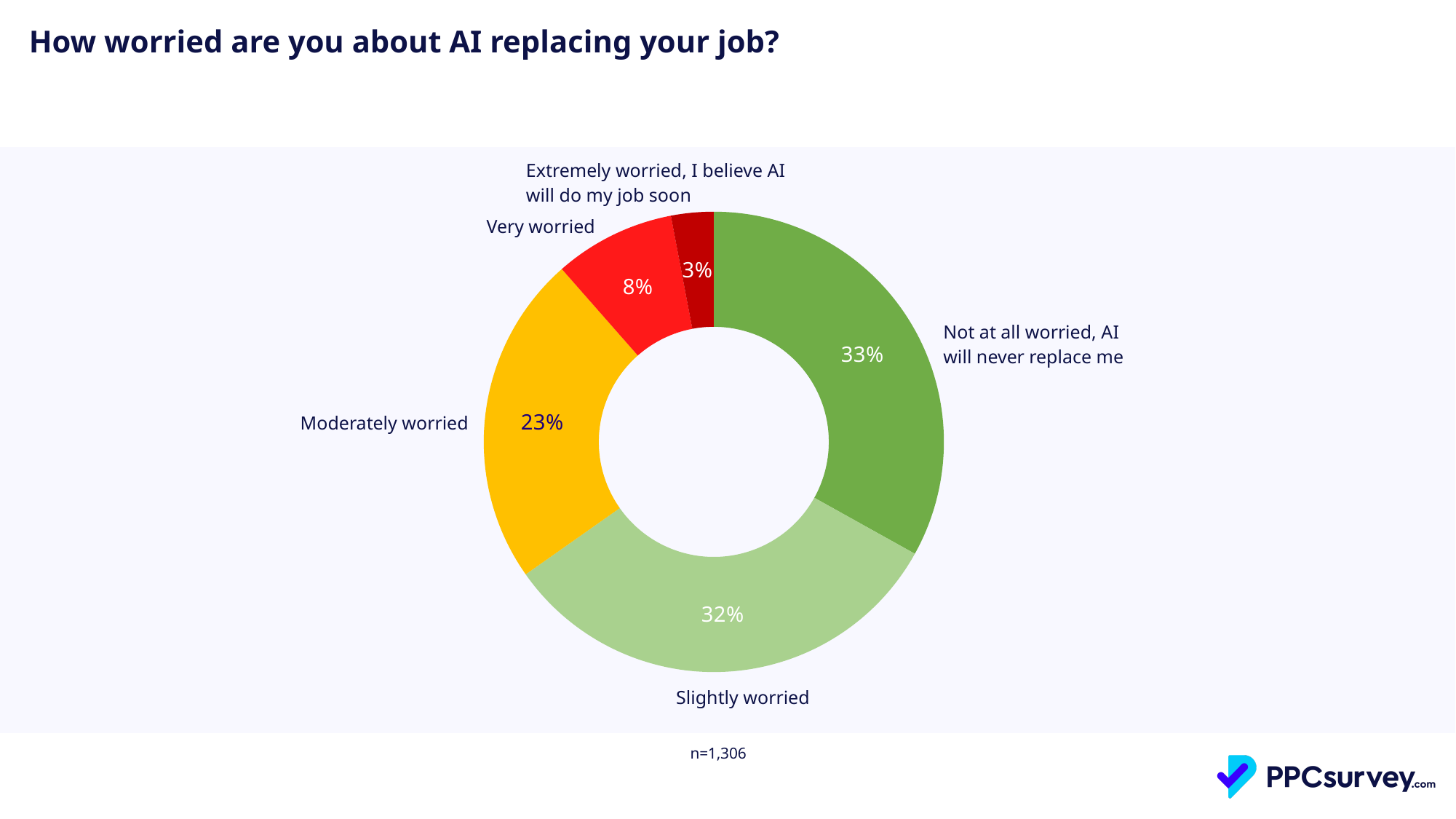
What percentage of respondents are "Not at all worried, AI will never replace me"? 33% What is the difference in percentage points between "Moderately worried" and "Very worried"? 15 What percentage of respondents are "Extremely worried, I believe AI will do my job soon"? 3% Which is larger: the share for "Moderately worried" or the share for "Very worried"? Moderately worried What percentage of respondents are "Slightly worried"? 32% What percentage of respondents are "Very worried"? 8% Which response category has the smallest share? Extremely worried, I believe AI will do my job soon How many response categories are shown in the chart? 5 Which response category has the largest share? Not at all worried, AI will never replace me What percentage of respondents are "Moderately worried"? 23% What kind of chart is shown on the slide? Pie chart (donut) What is the sample size (n) shown below the chart? n=1,306